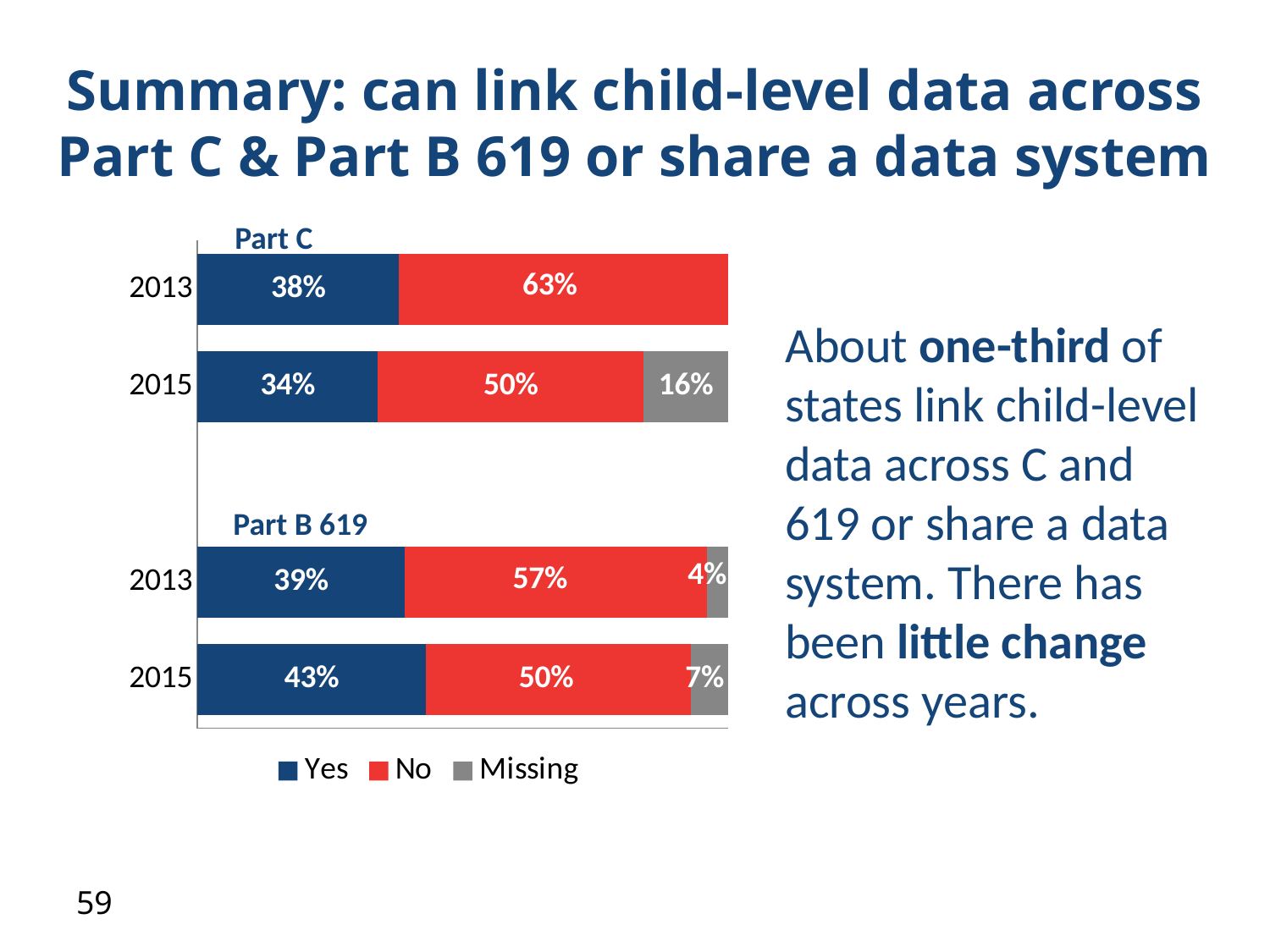
Which is larger: the "Missing" value for Part C in 2015 or for Part B 619 in 2015? Part C in 2015 How many bars are plotted in the chart? 4 Which bar has the highest "No" value? Part C, 2013 What is the "No" value for Part C in 2015? 50% What is the "Missing" value for Part B 619 in 2013? 4% What is the "Missing" value for Part C in 2015? 16% What is the "Yes" value for Part C in 2013? 38% How many series does the legend list? 3 What is the difference between the "Yes" values for Part B 619 in 2015 and 2013? 4% Which bar has the highest "Yes" value? Part B 619, 2015 What kind of chart is shown on the slide? stacked bar chart What is the "Yes" value for Part B 619 in 2015? 43%